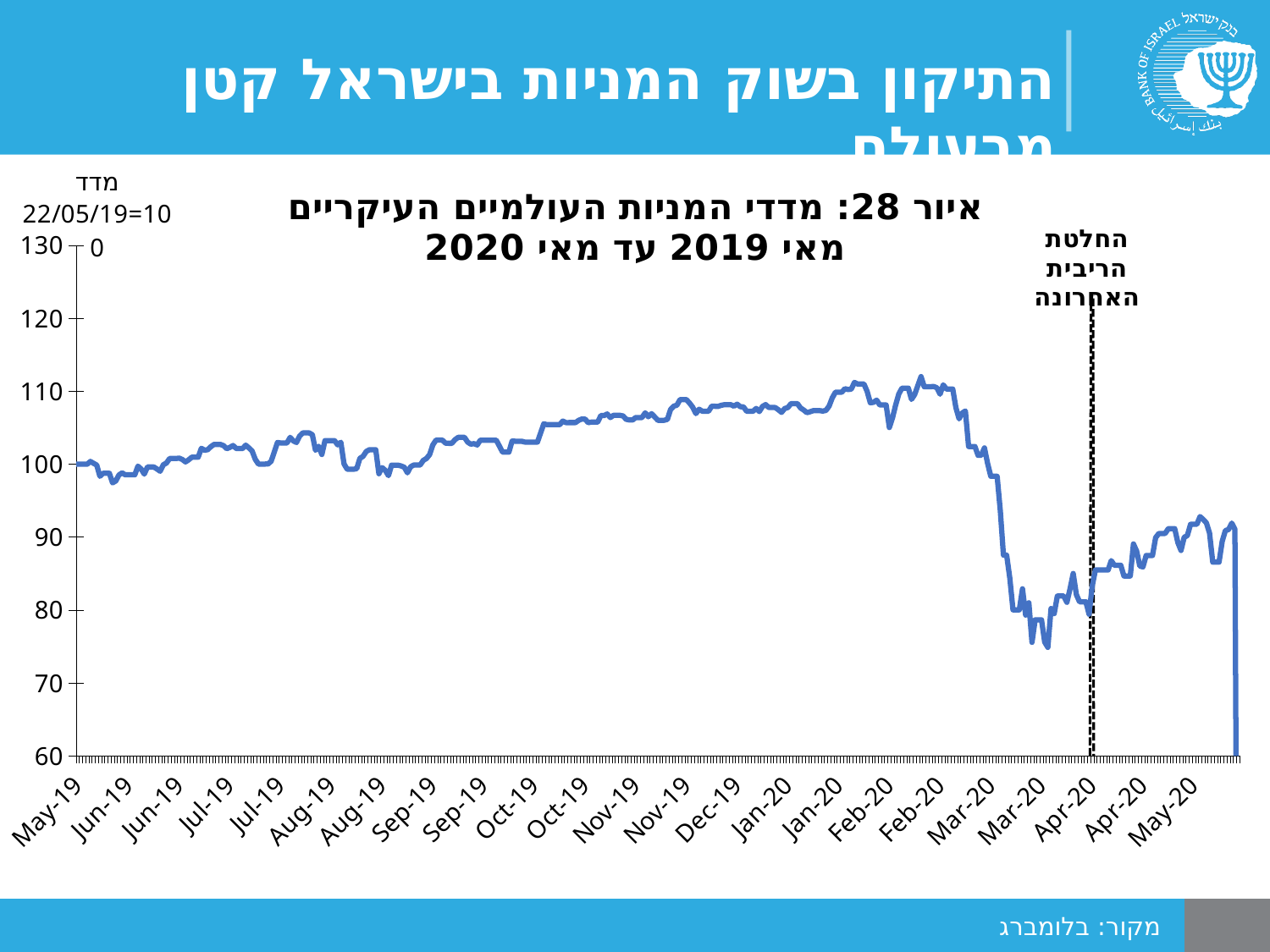
Is the value of the index around Dec-19 greater or less than 100? greater What is the base date at which the index equals 100, as stated on the slide? 22/05/19 Is the value of the index around Apr-20 greater or less than 100? less Is the lowest point of the index, reached around Mar-20, greater or less than 80? less What is the highest value shown on the vertical axis? 130 Does the index generally rise or fall between May-19 and Feb-20? rise How many data series are plotted in the chart? 1 What kind of chart is shown on the slide? line chart Does the index rise or fall between Feb-20 and Mar-20? fall